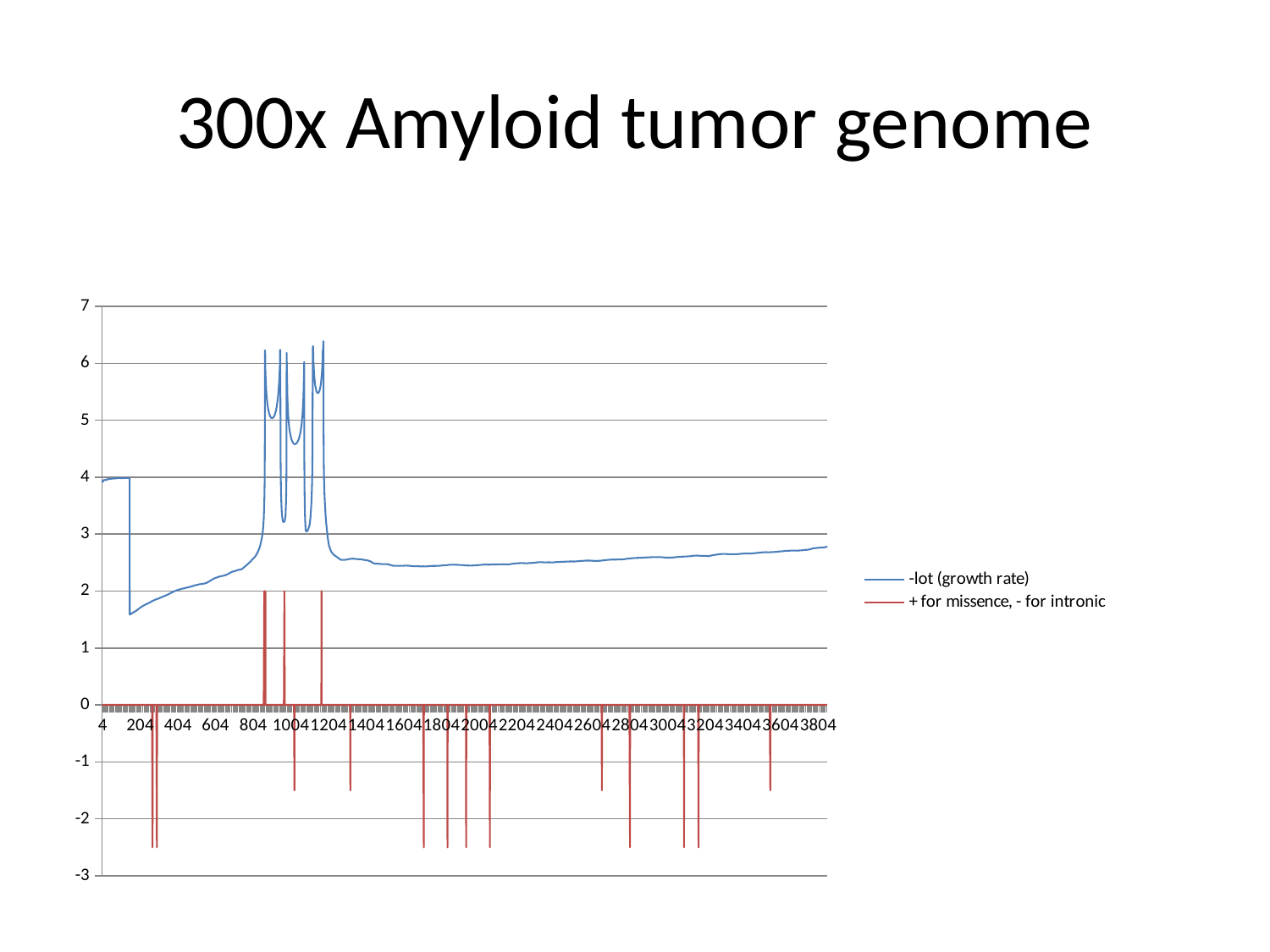
Which series is drawn in red according to the legend? + for missence, - for intronic What is the title of the chart? 300x Amyloid tumor genome Is the lowest point of the blue '-lot (growth rate)' line, near x = 204, greater or less than 2? less What kind of chart is shown on the slide? line chart How many series does the legend list? 2 Is the value of the blue '-lot (growth rate)' line at x = 2004 greater or less than 3? less Is the highest peak of the blue '-lot (growth rate)' line greater or less than 6? greater What is the highest value shown on the y axis? 7 How many positive (upward) red spikes are plotted? 3 Does the blue '-lot (growth rate)' line rise or fall between x = 2004 and x = 3804? rise